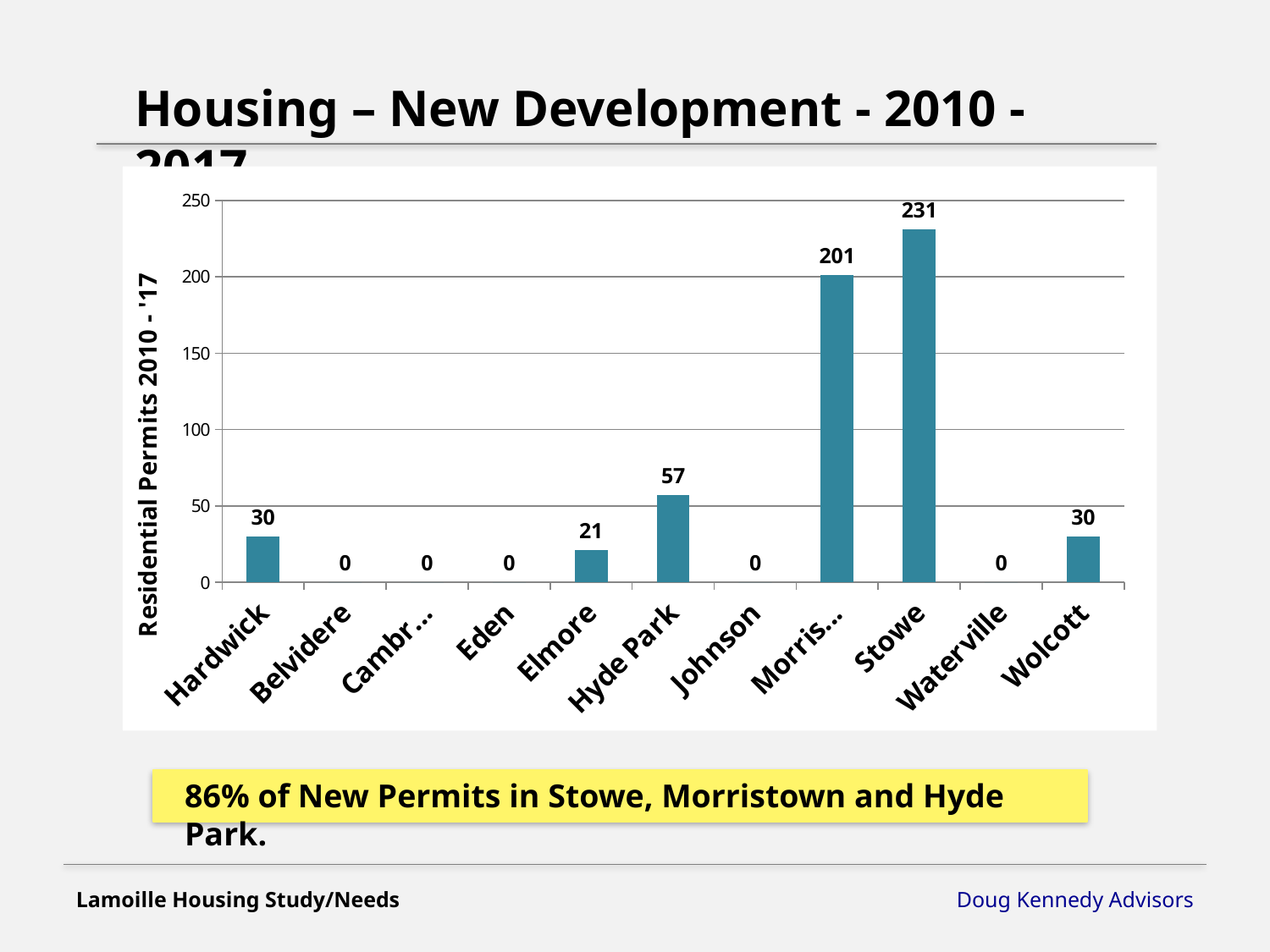
What is the label of the vertical axis of the chart? Residential Permits 2010 - '17 How many residential permits are shown for Hyde Park? 57 Is the value for Morristown greater or less than 150? greater What is the difference between the values for Stowe and Morristown? 30 What is the difference between the values for Hyde Park and Elmore? 36 What is the value shown for Waterville? 0 Which is larger, the value for Hardwick or the value for Hyde Park? Hyde Park Which town has the highest number of residential permits? Stowe How many residential permits are shown for Stowe? 231 What is the value shown for Elmore? 21 What kind of chart is shown on the slide? bar chart How many towns are shown on the x axis of the chart? 11